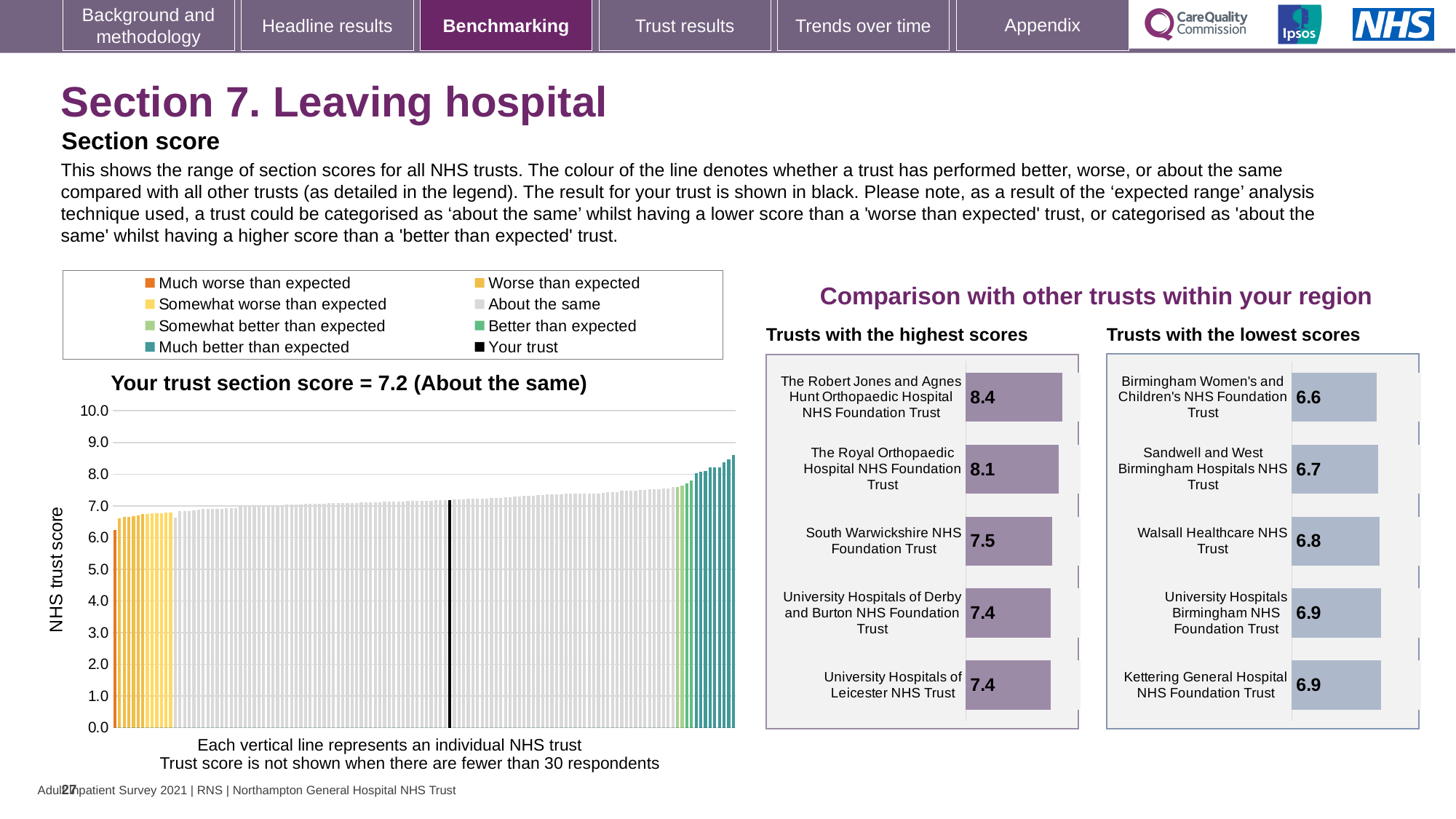
What kind of chart is the main chart on the left showing the range of section scores for all NHS trusts? Bar chart In the 'Trusts with the lowest scores' chart, which has the larger score: Sandwell and West Birmingham Hospitals NHS Trust or University Hospitals Birmingham NHS Foundation Trust? University Hospitals Birmingham NHS Foundation Trust In the 'Trusts with the highest scores' chart, what is the score for South Warwickshire NHS Foundation Trust? 7.5 In the 'Trusts with the lowest scores' chart, which trust has the lowest score? Birmingham Women's and Children's NHS Foundation Trust In the 'Trusts with the lowest scores' chart, what is the difference between the scores of Kettering General Hospital NHS Foundation Trust and Birmingham Women's and Children's NHS Foundation Trust? 0.3 According to the title of the main chart on the left, what is your trust's section score? 7.2 In the main chart on the left, do the trust scores rise or fall from left to right along the x axis? Rise In the 'Trusts with the lowest scores' chart, what is the score for Walsall Healthcare NHS Trust? 6.8 In the 'Trusts with the highest scores' chart, what is the score for The Robert Jones and Agnes Hunt Orthopaedic Hospital NHS Foundation Trust? 8.4 In the 'Trusts with the highest scores' chart, which trust has the highest score? The Robert Jones and Agnes Hunt Orthopaedic Hospital NHS Foundation Trust How many trusts are listed in the 'Trusts with the highest scores' chart? 5 In the 'Trusts with the highest scores' chart, what is the difference between the scores of The Royal Orthopaedic Hospital NHS Foundation Trust and South Warwickshire NHS Foundation Trust? 0.6